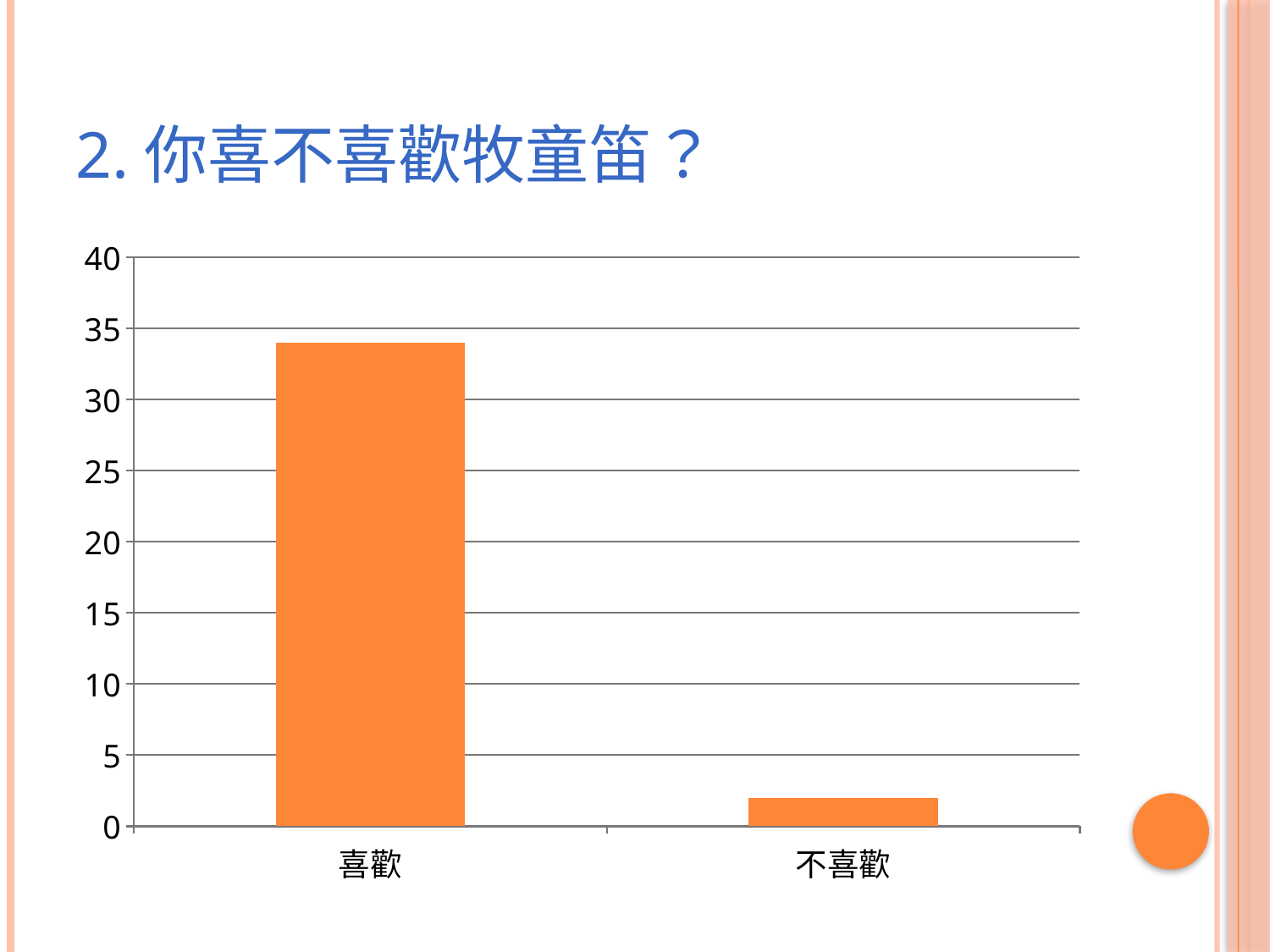
Is the value for 喜歡 greater or less than 30? greater What colour are the bars in the chart? orange How many categories are shown on the x axis of the chart? 2 Is the value for 不喜歡 greater or less than 10? less What is the title of the slide above the chart? 2. 你喜不喜歡牧童笛？ Which category has the lowest bar? 不喜歡 Which is larger, the value for 喜歡 or the value for 不喜歡? 喜歡 Is the value for 不喜歡 greater or less than 5? less What is the highest value shown on the y axis of the chart? 40 What kind of chart is shown on the slide? bar chart Which category has the highest bar? 喜歡